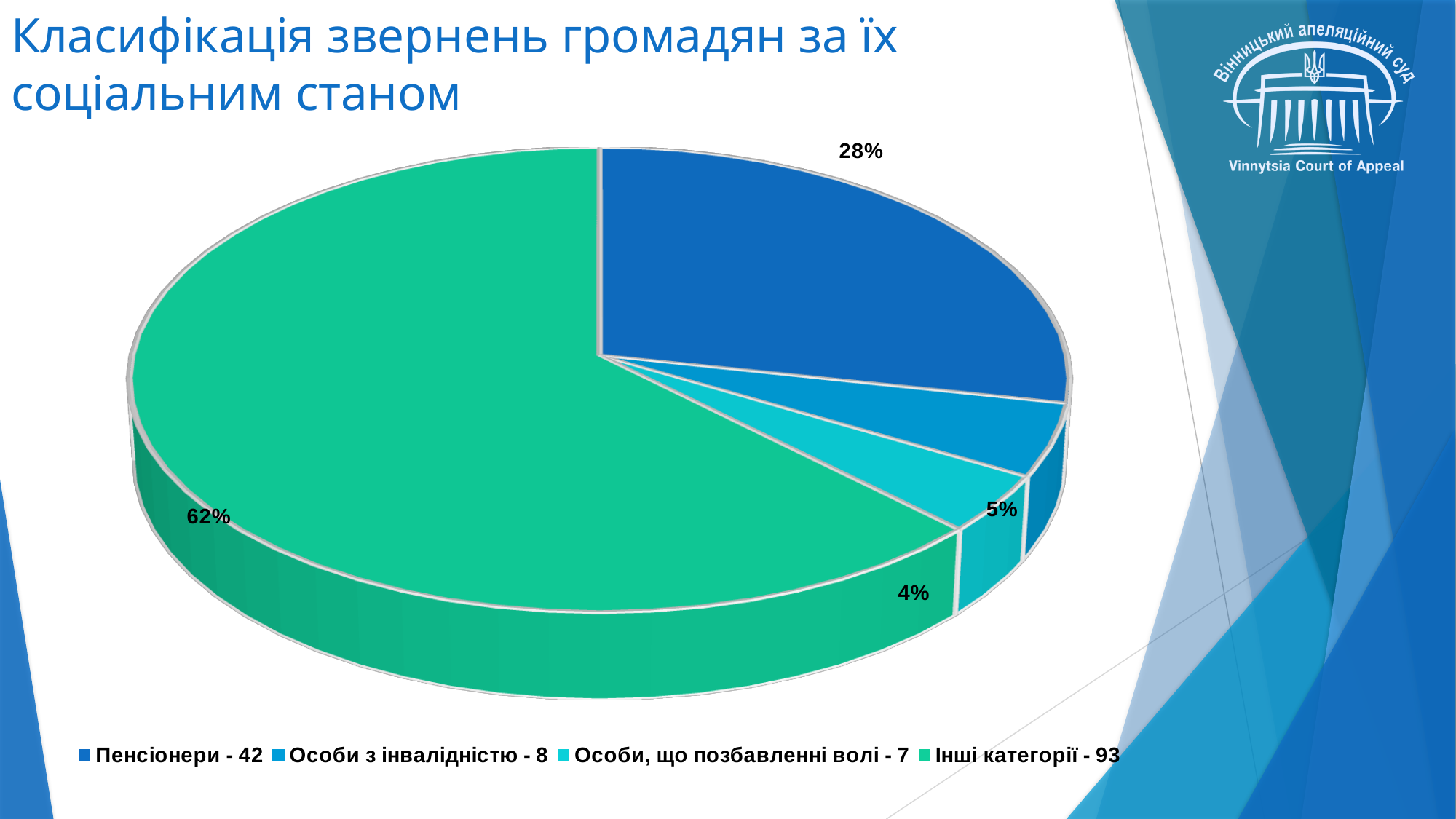
How many categories does the pie chart show? 4 What percentage share does the slice for Особи, що позбавленні волі have? 4% Which category has the largest slice of the pie? Інші категорії What percentage share does the slice for Пенсіонери have? 28% What kind of chart is shown on the slide? pie chart What percentage share does the slice for Інші категорії have? 62% According to the legend, how many appeals came from Інші категорії? 93 Which category has the smallest slice of the pie? Особи, що позбавленні волі What is the difference in percentage points between the Інші категорії slice and the Пенсіонери slice? 34 According to the legend, how many appeals came from Пенсіонери? 42 Which slice is larger: Особи з інвалідністю or Особи, що позбавленні волі? Особи з інвалідністю